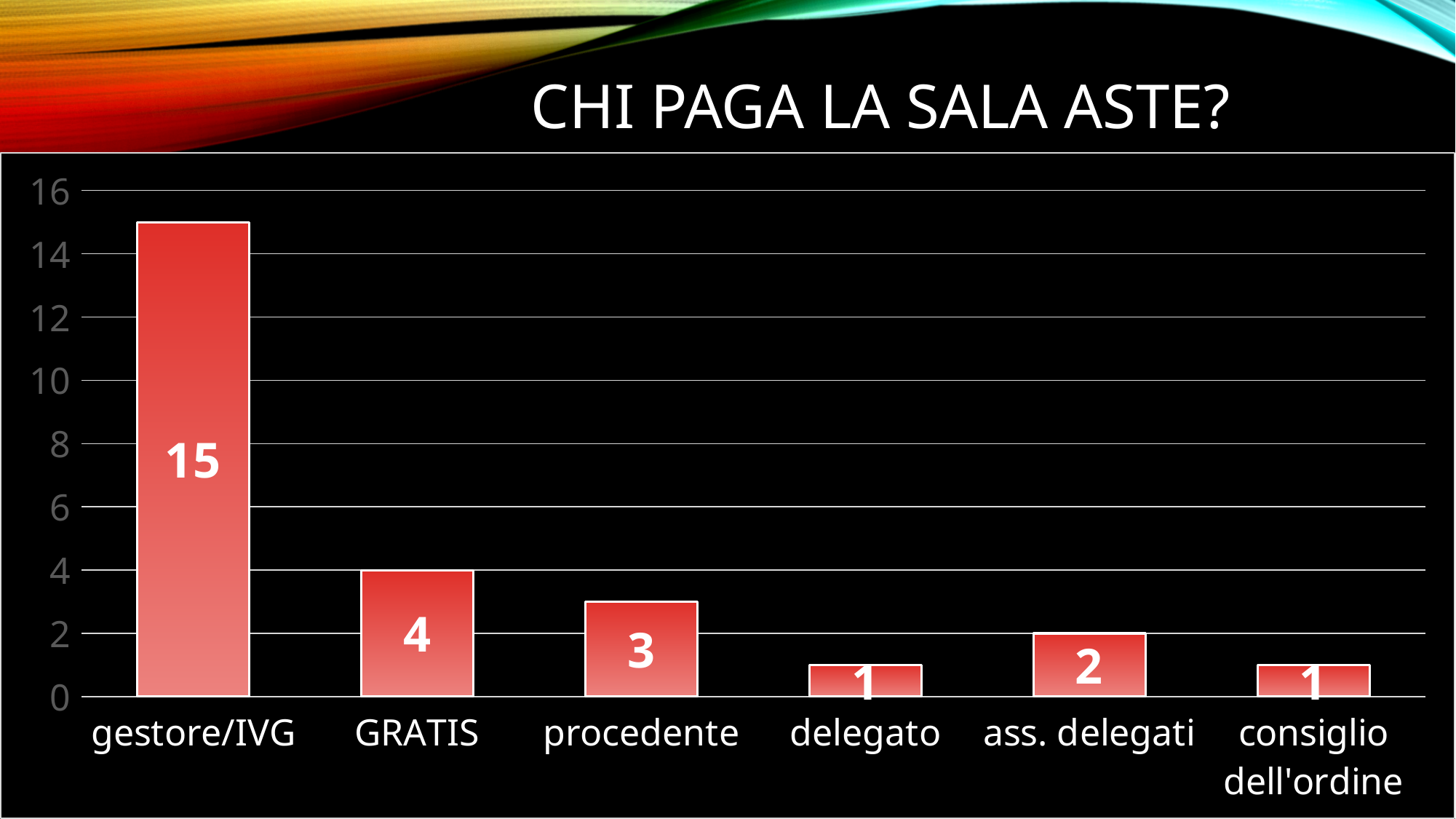
What kind of chart is shown on the slide? bar chart Which category has the highest value? gestore/IVG Which is larger, the value for procedente or the value for ass. delegati? procedente Is the value for gestore/IVG greater or less than 10? greater What is the title of the slide? CHI PAGA LA SALA ASTE? How many categories are shown on the x axis? 6 What is the value for ass. delegati? 2 What is the difference between the values for GRATIS and delegato? 3 What is the difference between the values for gestore/IVG and GRATIS? 11 What is the value for gestore/IVG? 15 What is the value for GRATIS? 4 What is the value for procedente? 3